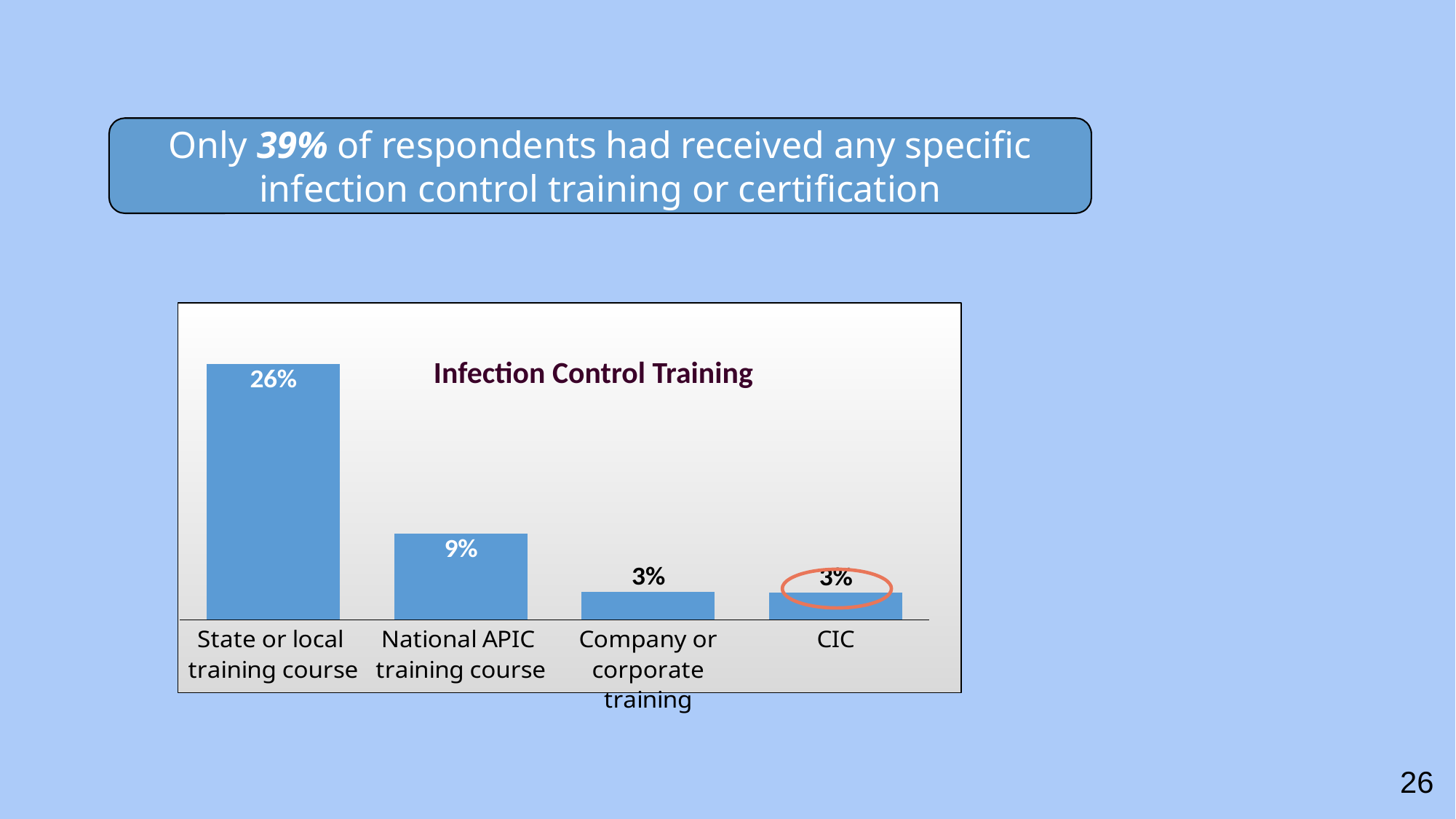
What is the title of the chart? Infection Control Training What is the value for National APIC training course? 9% What is the value for Company or corporate training? 3% What kind of chart is shown on the slide? Bar chart Which is larger, the value for State or local training course or the value for National APIC training course? State or local training course Which category has the highest value? State or local training course How many categories are shown in the chart? 4 What is the value for CIC? 3% What is the difference between the values for National APIC training course and CIC? 6% What is the difference between the values for State or local training course and National APIC training course? 17% Which category's data label is circled in red on the chart? CIC What is the value for State or local training course? 26%